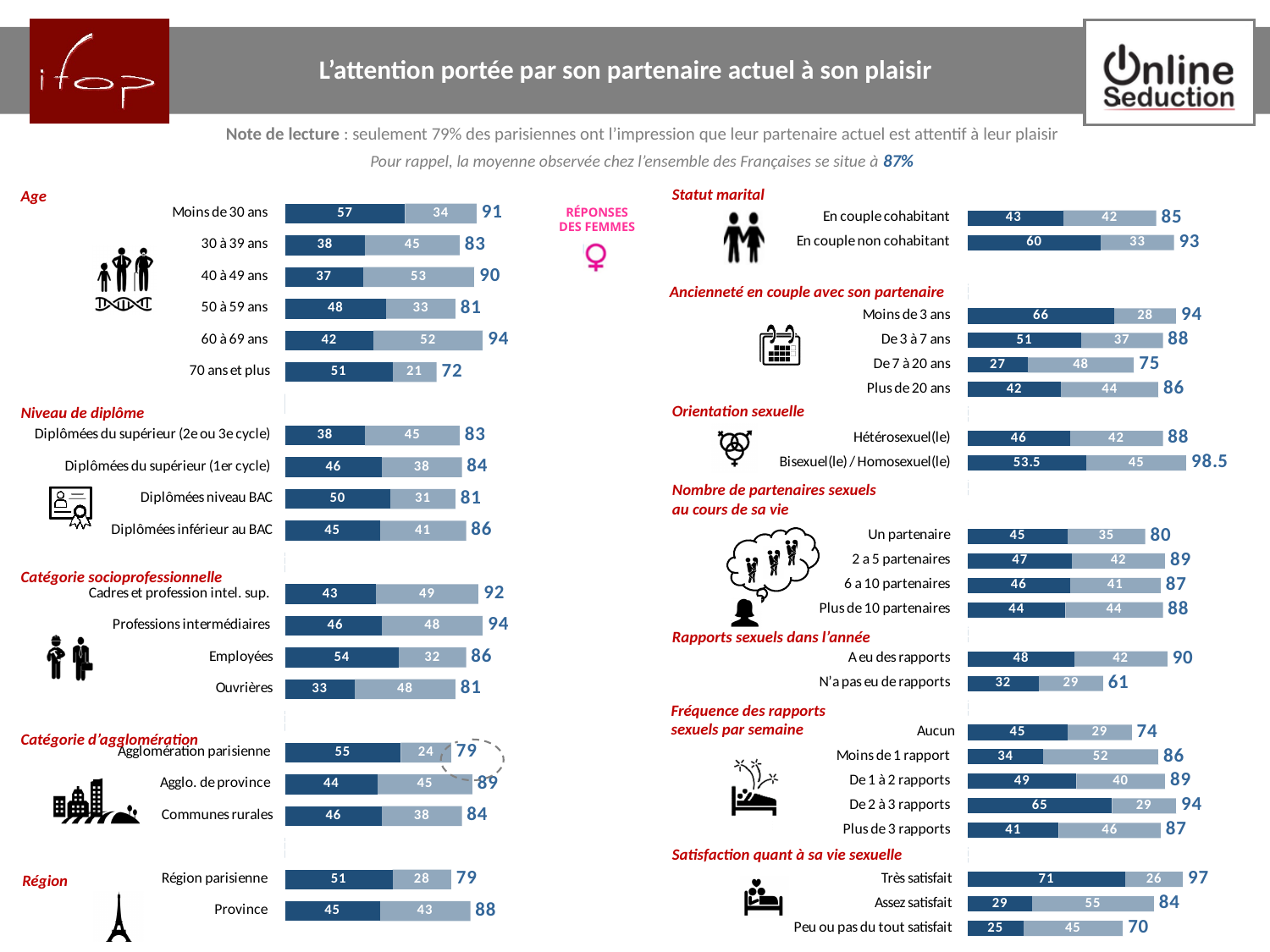
In the 'Catégorie d'agglomération' chart, what is the difference between the totals for 'Agglo. de province' and 'Agglomération parisienne'? 10 What type of chart is used throughout the slide? Stacked bar chart In the 'Orientation sexuelle' chart, what is the total for 'Bisexuel(le) / Homosexuel(le)'? 98.5 In the 'Ancienneté en couple avec son partenaire' chart, what is the total for 'De 7 à 20 ans'? 75 In the 'Age' chart, which age group has the lowest total? 70 ans et plus In the 'Catégorie socioprofessionnelle' chart, which category has the highest total? Professions intermédiaires In the 'Rapports sexuels dans l'année' chart, what is the difference between the totals for 'A eu des rapports' and 'N'a pas eu de rapports'? 29 In the 'Age' chart, what is the total shown for 'Moins de 30 ans'? 91 In the 'Niveau de diplôme' chart, how many categories are shown? 4 In the 'Age' chart, what is the value of the dark blue segment for '60 à 69 ans'? 42 In the 'Statut marital' chart, which has the larger total: 'En couple cohabitant' or 'En couple non cohabitant'? En couple non cohabitant In the 'Satisfaction quant à sa vie sexuelle' chart, what is the value of the light blue segment for 'Assez satisfait'? 55